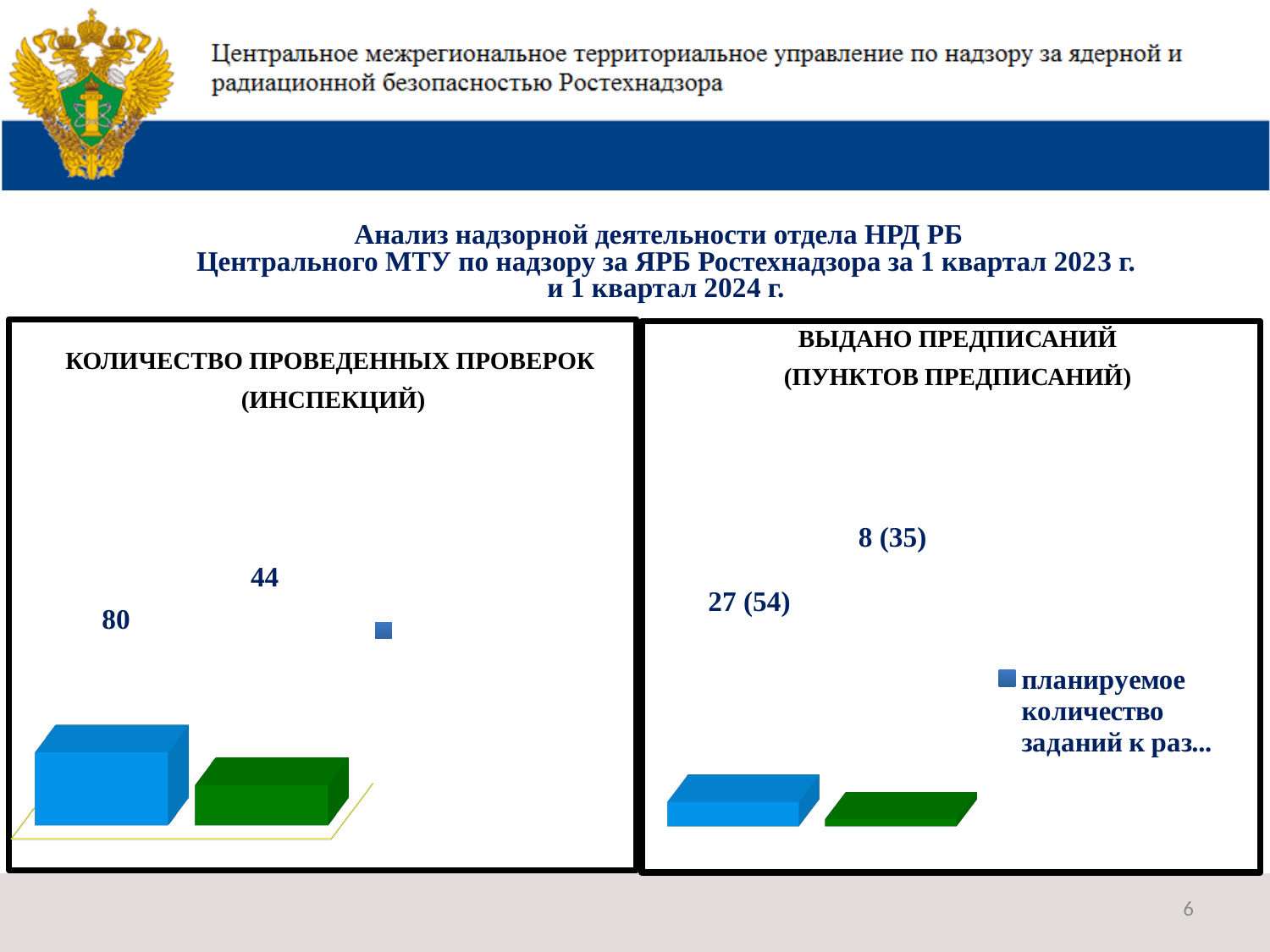
In the left chart (КОЛИЧЕСТВО ПРОВЕДЕННЫХ ПРОВЕРОК), which bar is taller, the blue one or the green one? the blue one What kind of chart is the right chart (ВЫДАНО ПРЕДПИСАНИЙ)? bar chart In the left chart (КОЛИЧЕСТВО ПРОВЕДЕННЫХ ПРОВЕРОК), what is the difference between the blue bar value and the green bar value? 36 In the right chart (ВЫДАНО ПРЕДПИСАНИЙ), what label is shown for the blue bar? 27 (54) In the left chart (КОЛИЧЕСТВО ПРОВЕДЕННЫХ ПРОВЕРОК), what value is shown for the blue bar? 80 What is the title of the left chart? КОЛИЧЕСТВО ПРОВЕДЕННЫХ ПРОВЕРОК (ИНСПЕКЦИЙ) In the right chart (ВЫДАНО ПРЕДПИСАНИЙ), what label is shown for the green bar? 8 (35) In the right chart (ВЫДАНО ПРЕДПИСАНИЙ), what is the difference between the number of предписаний for the blue bar (27) and the green bar (8)? 19 How many bars are plotted in the left chart (КОЛИЧЕСТВО ПРОВЕДЕННЫХ ПРОВЕРОК)? 2 In the right chart (ВЫДАНО ПРЕДПИСАНИЙ), which bar has the lower value, the blue one or the green one? the green one What is the title of the right chart? ВЫДАНО ПРЕДПИСАНИЙ (ПУНКТОВ ПРЕДПИСАНИЙ) In the left chart (КОЛИЧЕСТВО ПРОВЕДЕННЫХ ПРОВЕРОК), what value is shown for the green bar? 44